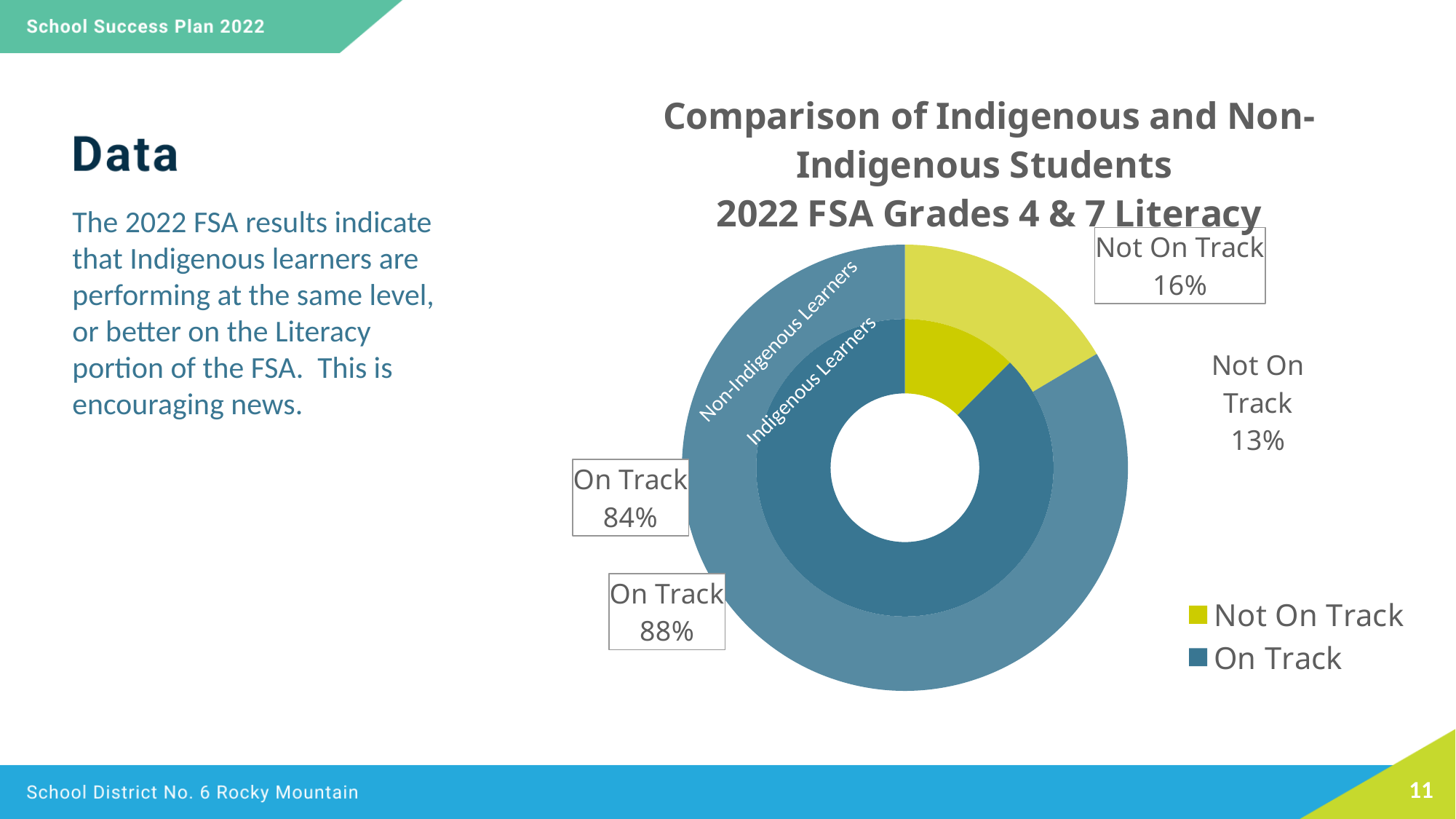
What percentage of Non-Indigenous Learners (outer ring) are On Track? 84% What kind of chart is shown on the slide? Doughnut chart What percentage of Non-Indigenous Learners (outer ring) are Not On Track? 16% What is the difference in percentage points between the Not On Track share for Non-Indigenous Learners (16%) and Indigenous Learners (13%)? 3 percentage points How many entries does the chart legend list? 2 What are the two groups of learners represented by the two rings of the chart? Non-Indigenous Learners and Indigenous Learners What percentage of Indigenous Learners (inner ring) are Not On Track? 13% What percentage of Indigenous Learners (inner ring) are On Track? 88% Which group has the higher On Track percentage, Indigenous Learners or Non-Indigenous Learners? Indigenous Learners Which two categories are shown in the chart legend? Not On Track and On Track What is the difference in percentage points between the On Track share for Indigenous Learners (88%) and Non-Indigenous Learners (84%)? 4 percentage points What is the title of the chart? Comparison of Indigenous and Non-Indigenous Students 2022 FSA Grades 4 & 7 Literacy